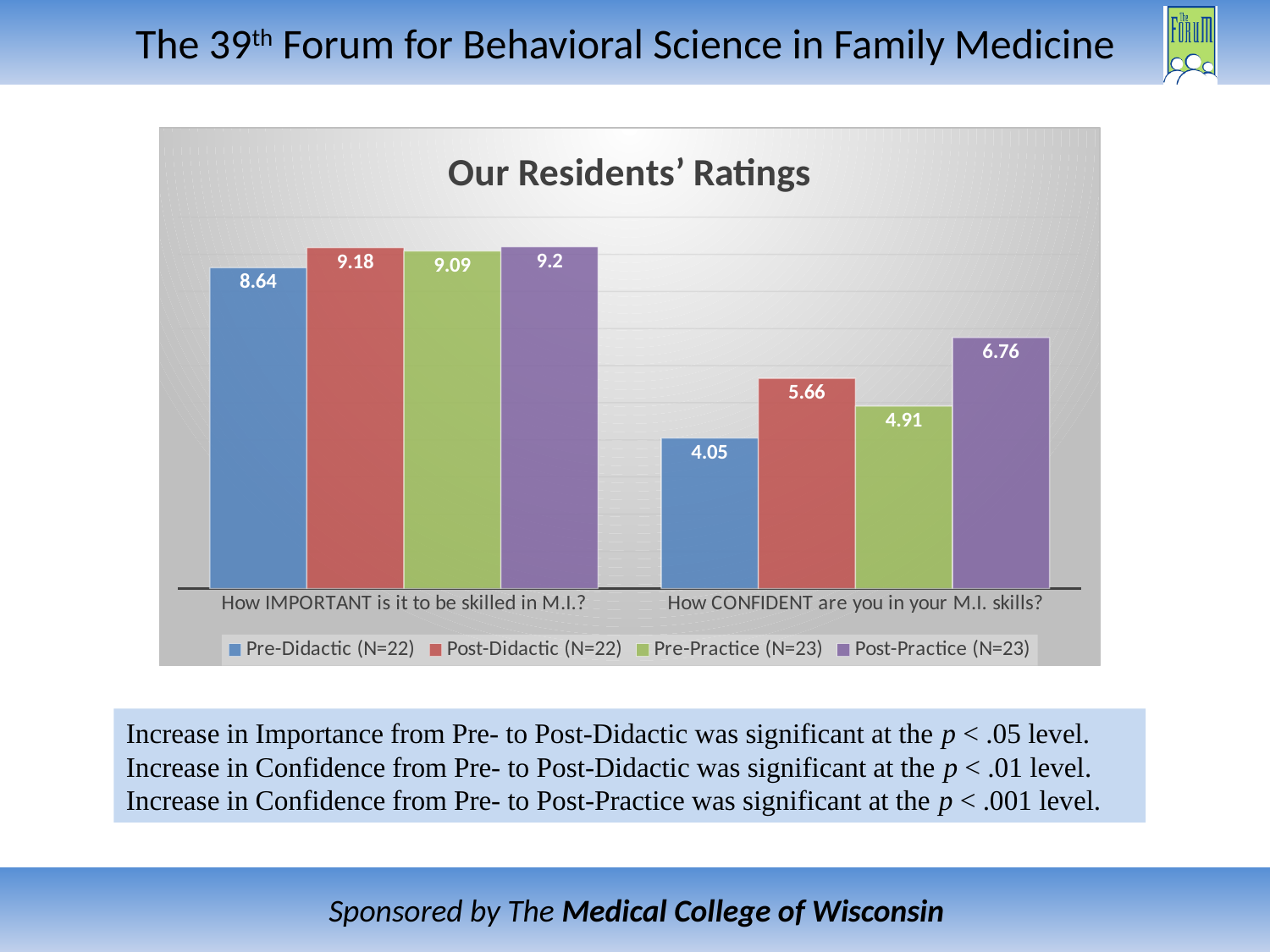
What is the Post-Practice (N=23) value for "How CONFIDENT are you in your M.I. skills?"? 6.76 Which series has the highest value for "How CONFIDENT are you in your M.I. skills?"? Post-Practice (N=23) What is the title of the chart? Our Residents' Ratings Which series has the lowest value for "How CONFIDENT are you in your M.I. skills?"? Pre-Didactic (N=22) What is the Pre-Practice (N=23) value for "How CONFIDENT are you in your M.I. skills?"? 4.91 What is the difference between the Post-Didactic (N=22) and Pre-Didactic (N=22) values for "How CONFIDENT are you in your M.I. skills?"? 1.61 What is the difference between the Post-Practice (N=23) and Pre-Practice (N=23) values for "How IMPORTANT is it to be skilled in M.I.?"? 0.11 How many series does the legend list? 4 Which series has the lowest value for "How IMPORTANT is it to be skilled in M.I.?"? Pre-Didactic (N=22) What is the Pre-Didactic (N=22) value for "How IMPORTANT is it to be skilled in M.I.?"? 8.64 How many categories are shown on the x axis? 2 Which is larger: the Post-Didactic (N=22) value or the Pre-Practice (N=23) value for "How CONFIDENT are you in your M.I. skills?"? Post-Didactic (N=22)